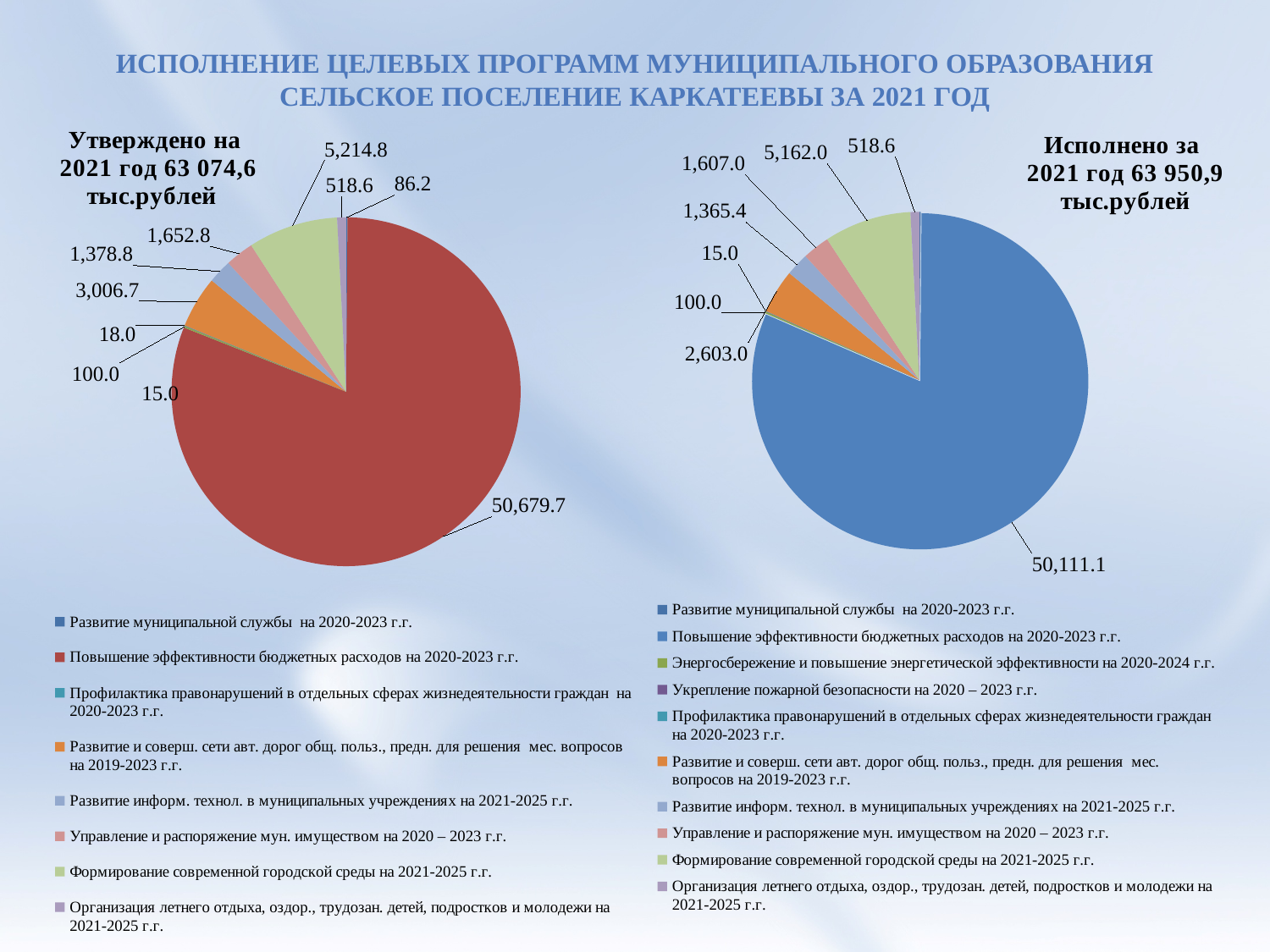
In the left chart (Утверждено на 2021 год), what is the value for the light green slice, Формирование современной городской среды? 5,214.8 In the right chart (Исполнено за 2021 год), what is the value for the light green slice, Формирование современной городской среды? 5,162.0 In the left chart (Утверждено на 2021 год), what is the largest labelled value? 50,679.7 Which chart shows a larger value for the road network slice (Развитие и соверш. сети авт. дорог): the left (Утверждено) or the right (Исполнено)? The left (Утверждено) According to the heading of the right chart, what total amount was executed in 2021? 63 950,9 тыс.рублей In the right chart (Исполнено за 2021 год), what is the largest labelled value? 50,111.1 What kind of charts are shown on the slide? Pie charts How many entries does the legend of the right chart (Исполнено за 2021 год) list? 10 In the left chart (Утверждено на 2021 год), what is the value for the orange slice, Развитие и соверш. сети авт. дорог? 3,006.7 In the right chart (Исполнено за 2021 год), what is the value for the orange slice, Развитие и соверш. сети авт. дорог? 2,603.0 What is the difference between the Формирование современной городской среды value in the left chart (5,214.8) and in the right chart (5,162.0)? 52.8 How many entries does the legend of the left chart (Утверждено на 2021 год) list? 8